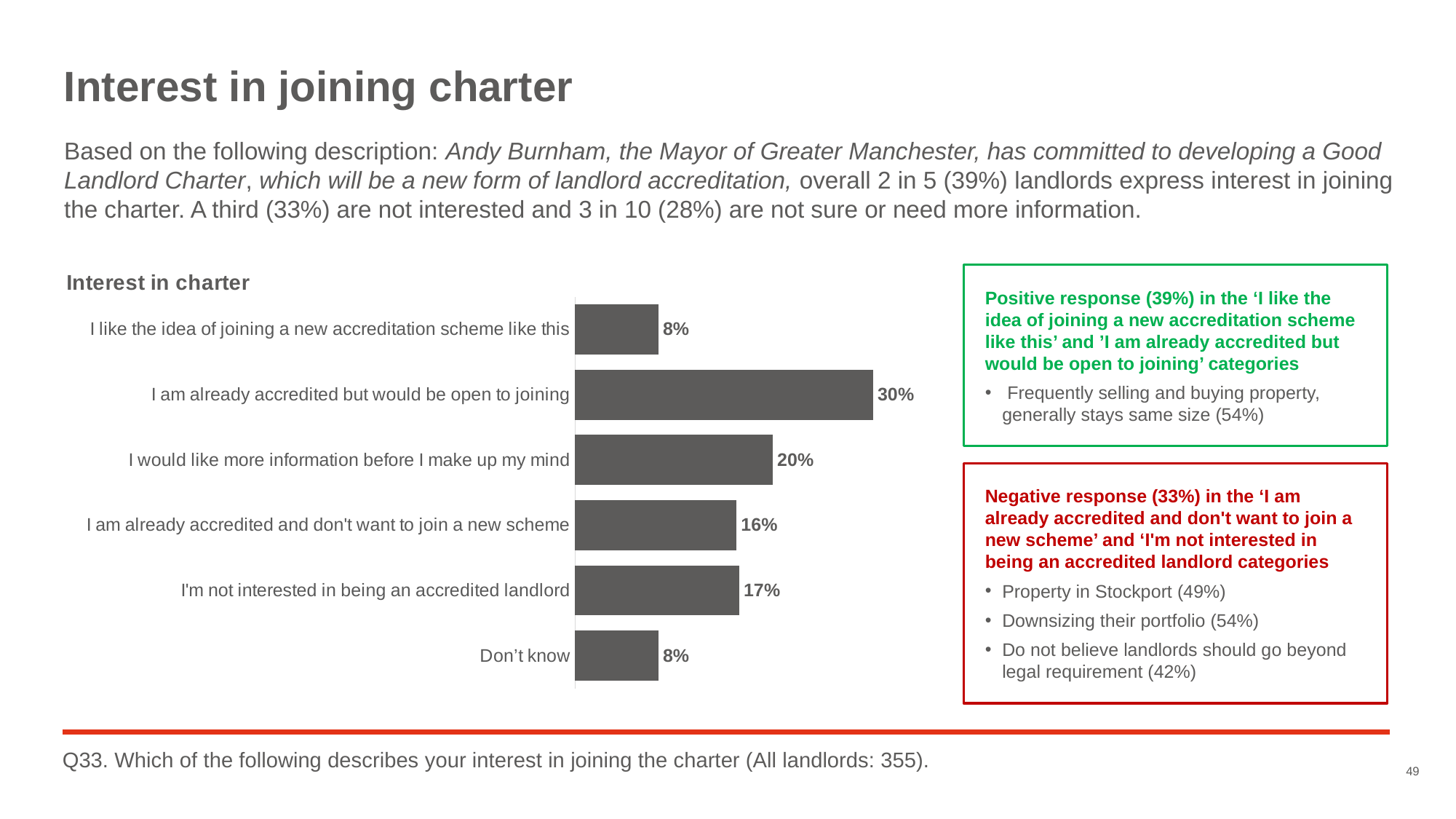
What percentage of landlords said 'I am already accredited but would be open to joining'? 30% What is the difference in percentage points between 'I am already accredited but would be open to joining' and 'I would like more information before I make up my mind'? 10 percentage points What is the combined percentage of 'I like the idea of joining a new accreditation scheme like this' and 'Don't know'? 16% What is the title of the chart on the slide? Interest in charter Which response category has the highest percentage in the 'Interest in charter' chart? I am already accredited but would be open to joining What type of chart is used to show interest in the charter? Bar chart How many response categories are shown in the 'Interest in charter' chart? 6 Which is larger: the percentage for 'I'm not interested in being an accredited landlord' or for 'I am already accredited and don't want to join a new scheme'? I'm not interested in being an accredited landlord What percentage of landlords said 'I am already accredited and don't want to join a new scheme'? 16% What percentage of landlords said 'I would like more information before I make up my mind'? 20% What percentage of landlords said 'I'm not interested in being an accredited landlord'? 17% What percentage of landlords answered 'Don't know'? 8%